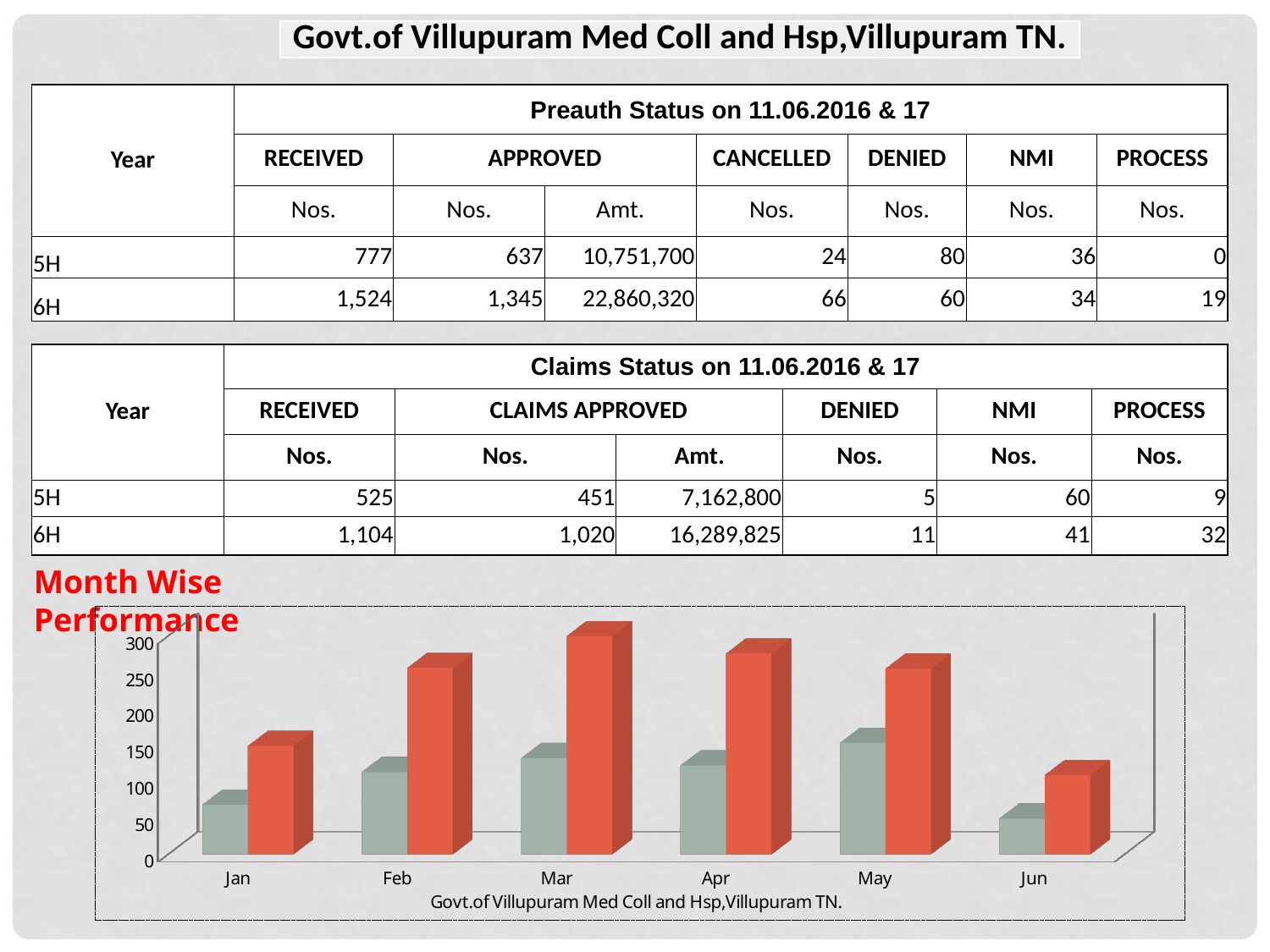
In the Month Wise Performance chart, is the red bar for Feb greater or less than 200? greater How many bars are plotted for each month in the Month Wise Performance chart? 2 In the Month Wise Performance chart, is the grey bar for Jan greater or less than 100? less In the Month Wise Performance chart, which month has the shortest grey bar? Jun How many months are shown on the x axis of the Month Wise Performance chart? 6 In the Month Wise Performance chart, do the red bars rise or fall from Mar to Jun? fall In the Month Wise Performance chart, for Jan, which bar is taller, the grey bar or the red bar? the red bar What kind of chart is shown under the heading 'Month Wise Performance'? bar chart In the Month Wise Performance chart, which month has the shortest red bar? Jun In the Month Wise Performance chart, is the red bar for Jun greater or less than 150? less In the Month Wise Performance chart, which month has the tallest red bar? Mar